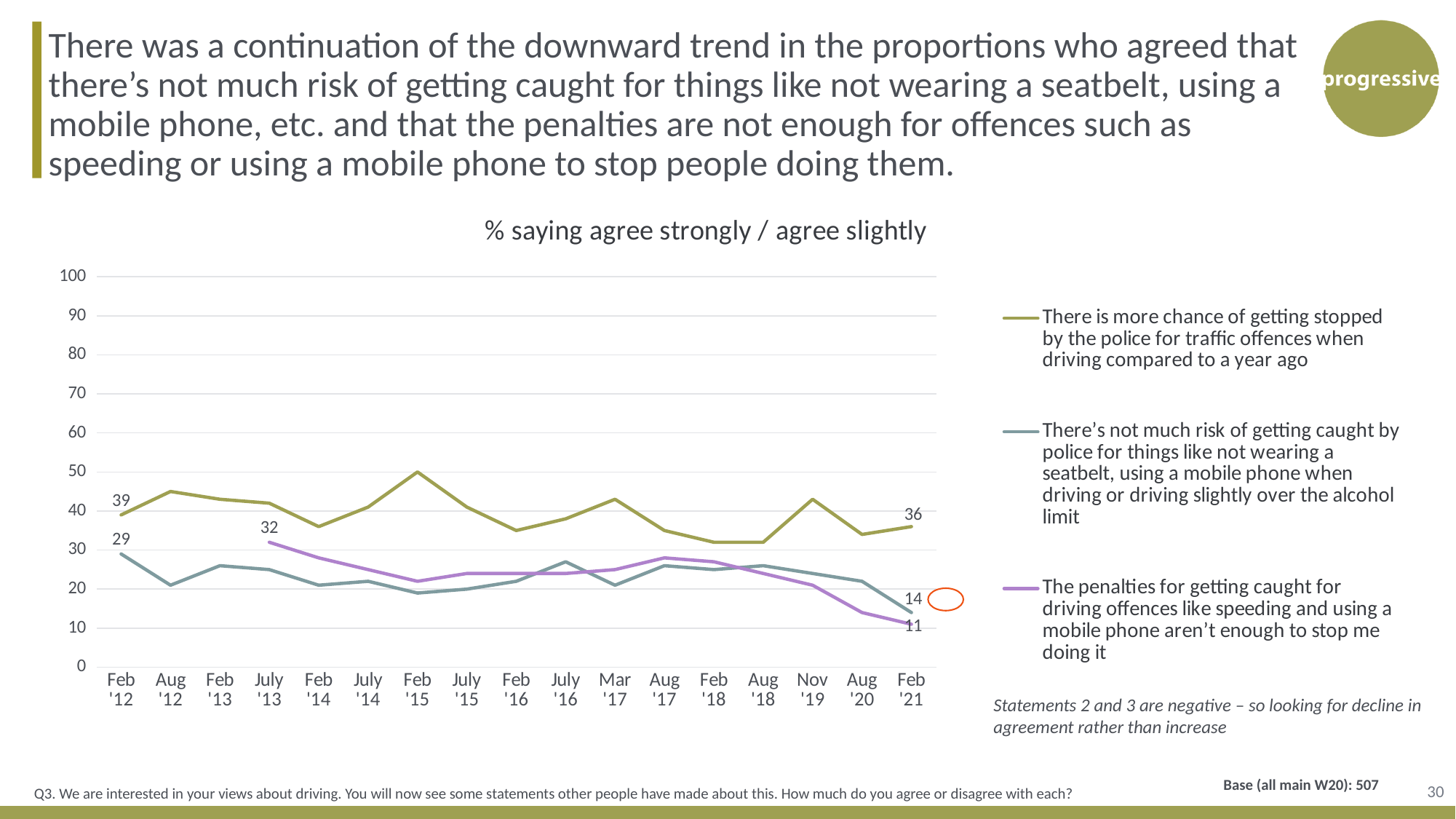
Does the 'The penalties for getting caught ... aren't enough' series rise or fall from July '13 to Feb '21? Fall By how much did the 'There's not much risk of getting caught by police' series fall between Feb '12 and Feb '21? 15 What kind of chart is shown on the slide? Line chart In Feb '21, which is larger: the 'There's not much risk of getting caught' series or the 'The penalties ... aren't enough' series? There's not much risk of getting caught What is the difference between the 'There is more chance of getting stopped' series and the 'There's not much risk of getting caught' series in Feb '21? 22 What is the value for the 'There is more chance of getting stopped by the police' series in Feb '12? 39 Which series has the highest value in Feb '21? There is more chance of getting stopped by the police for traffic offences when driving compared to a year ago How many series does the legend list? 3 How many time points are shown along the x axis? 17 What is the value for the 'There's not much risk of getting caught by police' series in Feb '21? 14 What is the value for the 'The penalties for getting caught ... aren't enough' series in July '13? 32